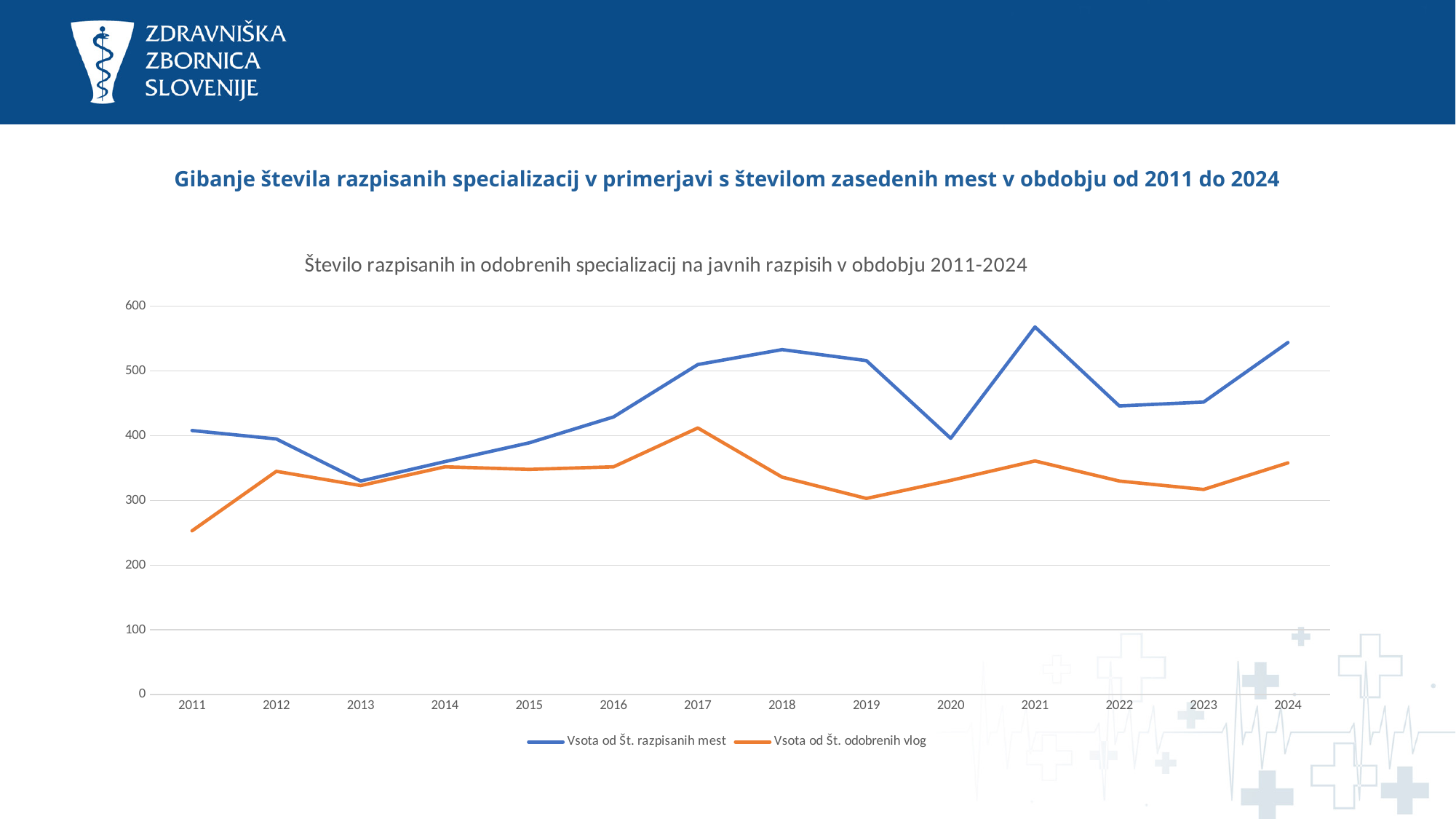
Is the value for 'Vsota od Št. odobrenih vlog' in 2011 greater or less than 300? less Is the value for 'Vsota od Št. razpisanih mest' in 2013 greater or less than 400? less Is the value for 'Vsota od Št. razpisanih mest' in 2021 greater or less than 500? greater In which year does the series 'Vsota od Št. odobrenih vlog' reach its highest value? 2017 How many series does the legend list? 2 What kind of chart is shown on the slide? line chart Does the series 'Vsota od Št. odobrenih vlog' rise or fall from 2017 to 2019? fall In which year does the series 'Vsota od Št. razpisanih mest' reach its highest value? 2021 How many years are plotted along the x axis? 14 In which year does the series 'Vsota od Št. razpisanih mest' reach its lowest value? 2013 Which series has the larger value in 2024, 'Vsota od Št. razpisanih mest' or 'Vsota od Št. odobrenih vlog'? Vsota od Št. razpisanih mest In which year does the series 'Vsota od Št. odobrenih vlog' reach its lowest value? 2011